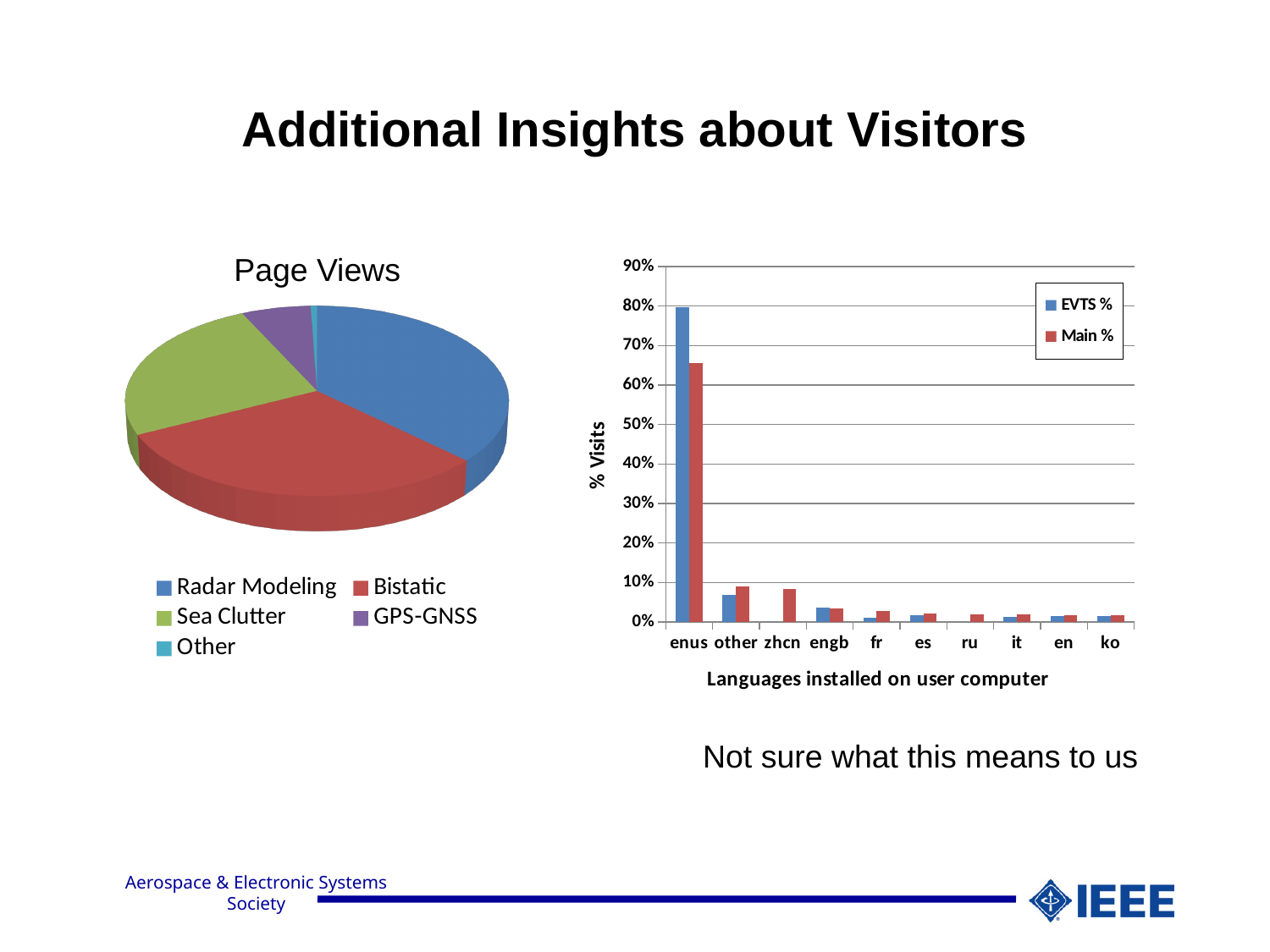
How many slices does the Page Views pie chart have? 5 In the bar chart on the right, is the Main % value for enus greater or less than 70%? less What kind of chart is the chart on the right of the slide? bar chart What is the x-axis title of the bar chart on the right? Languages installed on user computer In the bar chart on the right, is the EVTS % value for enus greater or less than 70%? greater In the bar chart on the right, which language has the highest EVTS % value? enus In the bar chart on the right, which is larger for enus, EVTS % or Main %? EVTS % In the Page Views pie chart, which category has the smallest slice? Other How many language categories are shown on the x axis of the bar chart on the right? 10 What kind of chart is the Page Views chart? pie chart How many series does the legend of the bar chart on the right list? 2 In the bar chart on the right, which is larger for zhcn, EVTS % or Main %? Main %